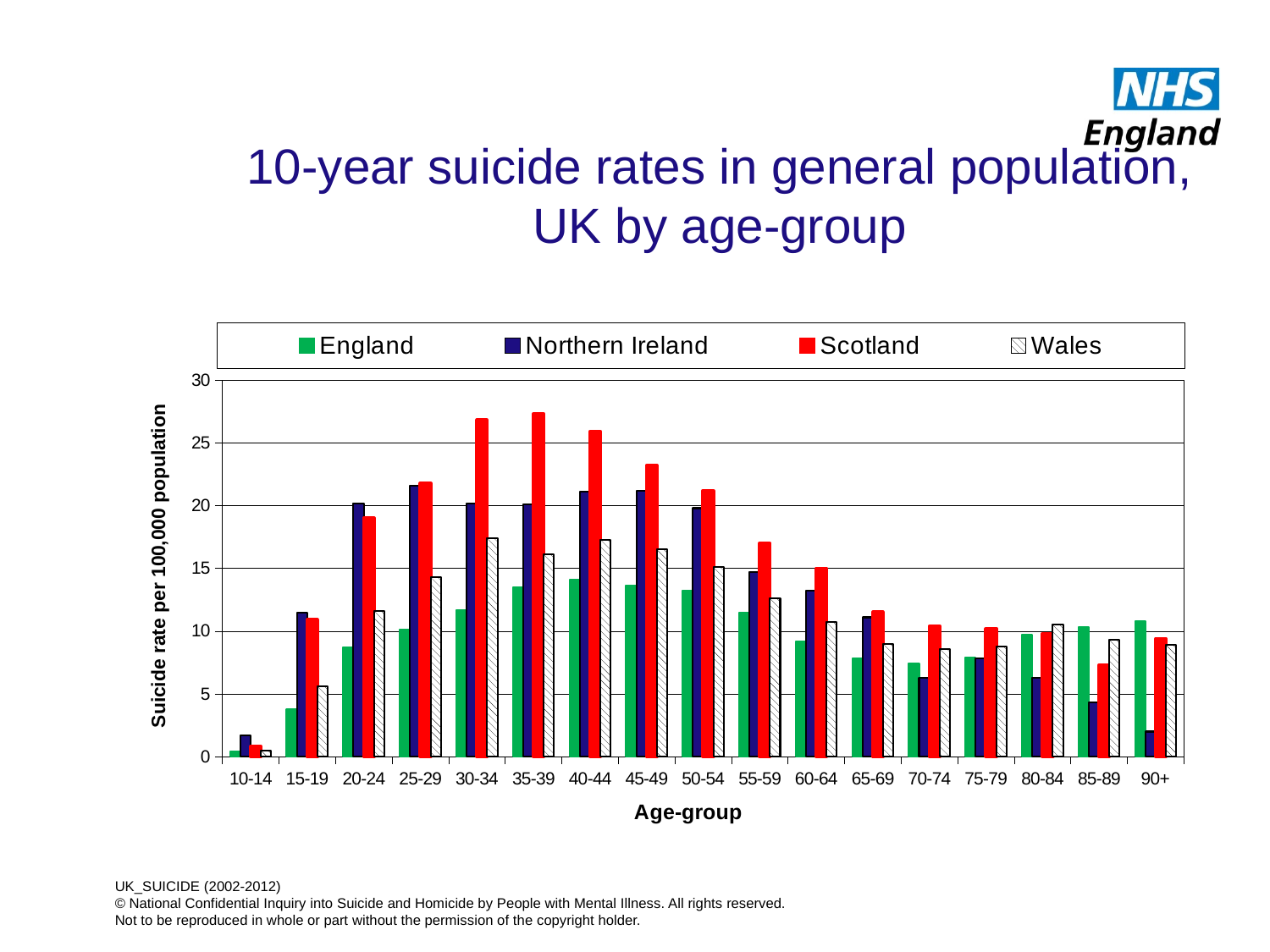
In the 90+ age-group, which is larger: the value for England or the value for Northern Ireland? England Is the value for England in the 40-44 age-group greater or less than 15? less How many series does the legend list? 4 What kind of chart is shown on the slide? bar chart Which age-group has the lowest suicide rate for Scotland? 10-14 In the 85-89 age-group, which is larger: the value for Northern Ireland or the value for Wales? Wales Is the value for Wales in the 20-24 age-group greater or less than 10? greater Is the value for Scotland in the 55-59 age-group greater or less than 15? greater What is the label of the y axis? Suicide rate per 100,000 population How many age-group categories are shown on the x axis? 17